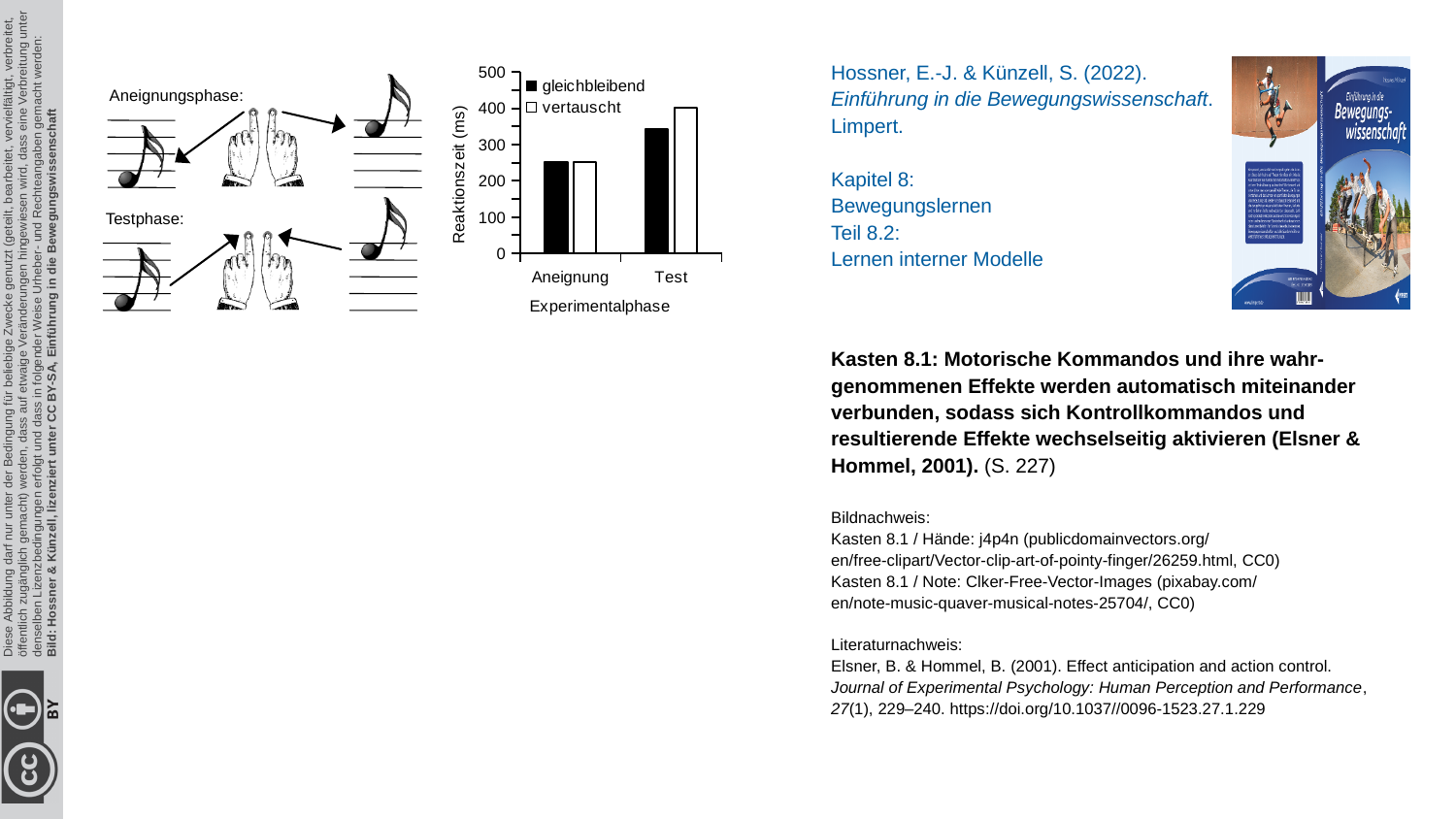
Is the value for vertauscht in the Aneignung phase greater or less than 200? greater Is the value for gleichbleibend in the Aneignung phase greater or less than 300? less Is the value for vertauscht in the Test phase greater or less than 300? greater How many categories are shown on the x axis of the chart? 2 Does the reaction time for the gleichbleibend series rise or fall from Aneignung to Test? rise What is the title of the x axis of the chart? Experimentalphase What is the title of the y axis of the chart? Reaktionszeit (ms) For the vertauscht series, which experimental phase has the highest reaction time? Test In the Test phase, which series has the larger value, gleichbleibend or vertauscht? vertauscht What kind of chart is shown on the slide? bar chart How many series does the chart's legend list? 2